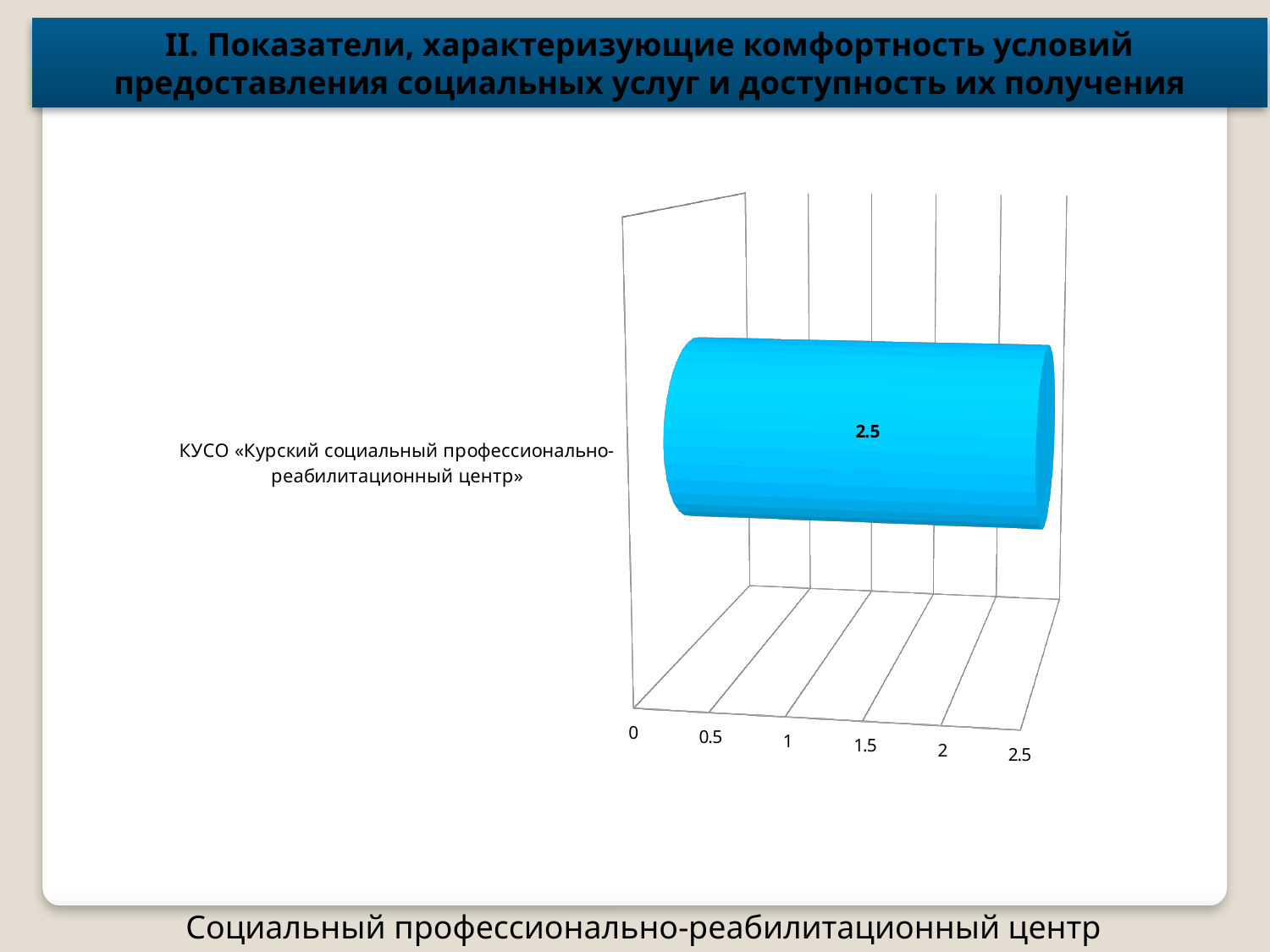
What colour is the bar in the chart? blue Is the value for КУСО «Курский социальный профессионально-реабилитационный центр» greater or less than 1? greater What kind of chart is shown on the slide? bar chart What is the maximum value shown on the chart's value axis? 2.5 What is the value shown for КУСО «Курский социальный профессионально-реабилитационный центр»? 2.5 Are the bars in the chart horizontal or vertical? horizontal How many categories are plotted in the chart? 1 Is the value for КУСО «Курский социальный профессионально-реабилитационный центр» greater or less than 2? greater